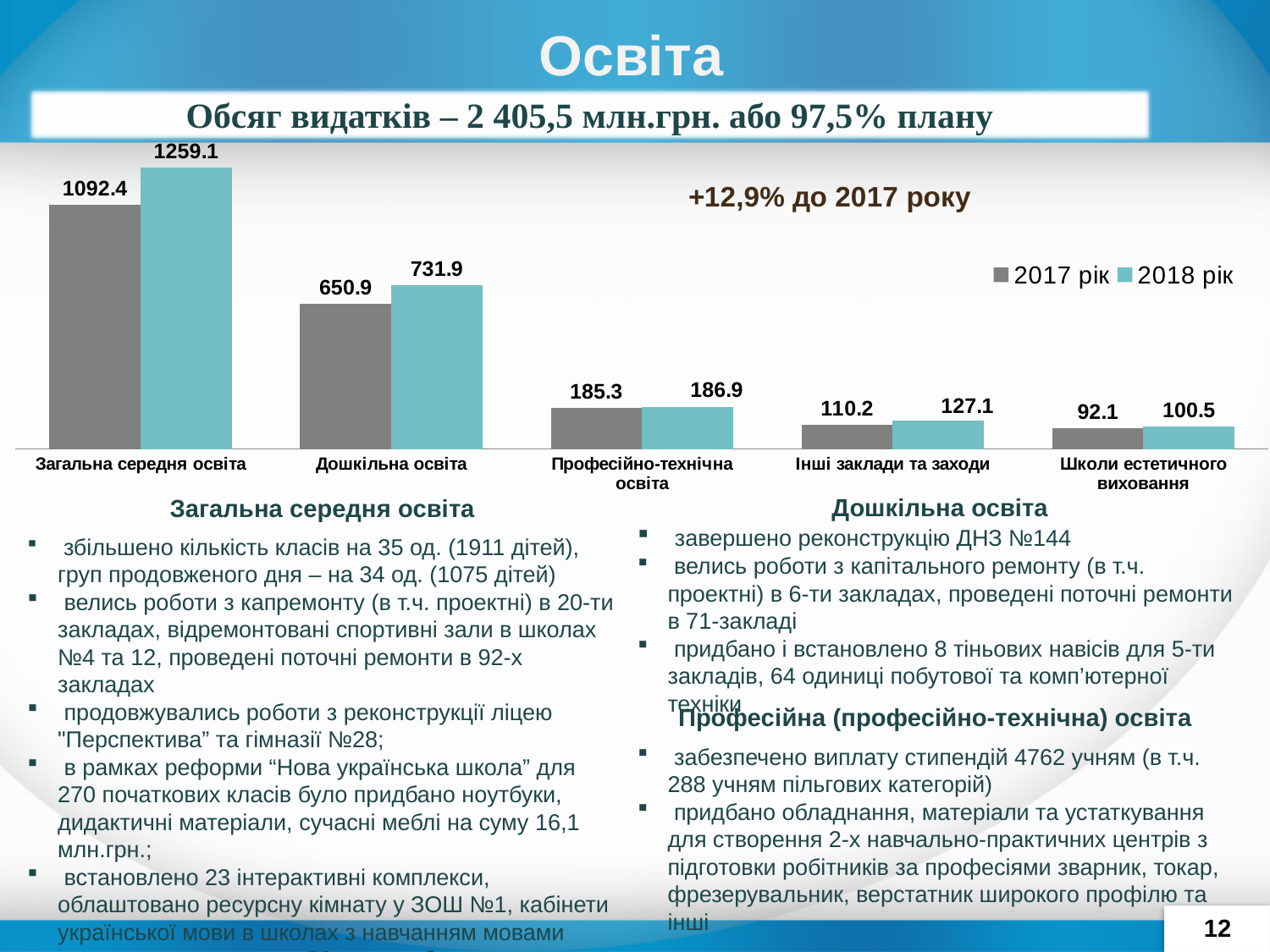
What kind of chart is shown on the slide? Bar chart What is the value for Інші заклади та заходи in the 2017 рік series? 110.2 Which category has the highest value in the 2018 рік series? Загальна середня освіта What is the difference between the 2018 рік and 2017 рік values for Загальна середня освіта? 166.7 Which category has the lowest value in the 2017 рік series? Школи естетичного виховання How many categories are shown on the x axis of the chart? 5 What is the value for Загальна середня освіта in the 2018 рік series? 1259.1 What is the difference between the 2018 рік and 2017 рік values for Дошкільна освіта? 81.0 What is the value for Школи естетичного виховання in the 2018 рік series? 100.5 Which is larger: the 2017 рік value for Дошкільна освіта or the 2018 рік value for Професійно-технічна освіта? 2017 рік value for Дошкільна освіта How many series does the chart legend list? 2 What is the value for Дошкільна освіта in the 2017 рік series? 650.9